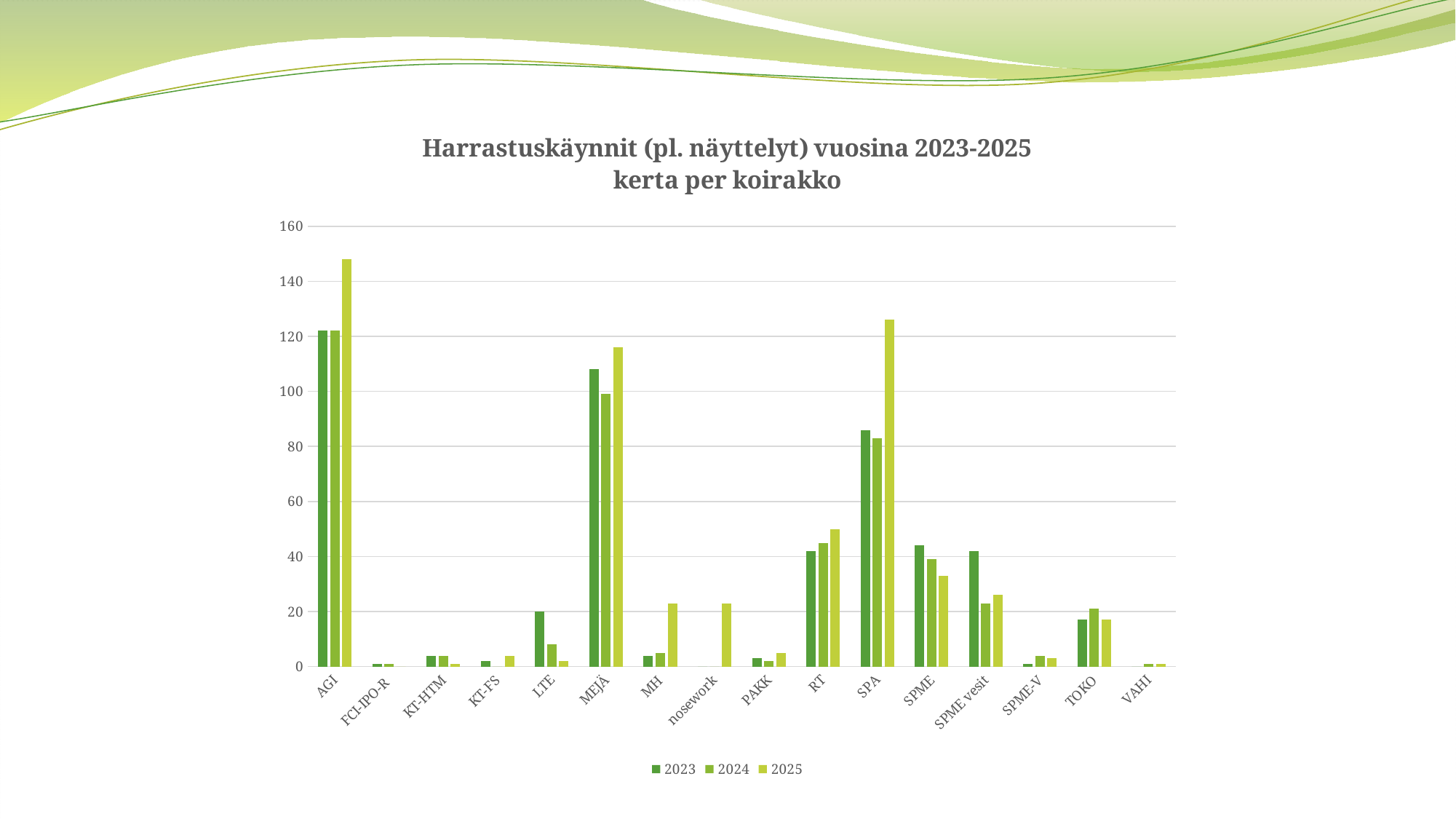
How many series does the legend list? 3 What is the title of the chart? Harrastuskäynnit (pl. näyttelyt) vuosina 2023-2025 kerta per koirakko Is the value for AGI in 2025 greater or less than 140? greater Is the value for MEJÄ in 2023 greater or less than 100? greater Is the value for SPA in 2025 greater or less than 120? greater Which category has the highest bar in the chart? AGI Which is larger for MEJÄ: the 2023 value or the 2024 value? 2023 What kind of chart is shown on the slide? bar chart Do the values for SPME rise or fall from 2023 to 2025? fall How many categories are shown on the x axis? 16 Which is larger for SPA: the 2023 value or the 2025 value? 2025